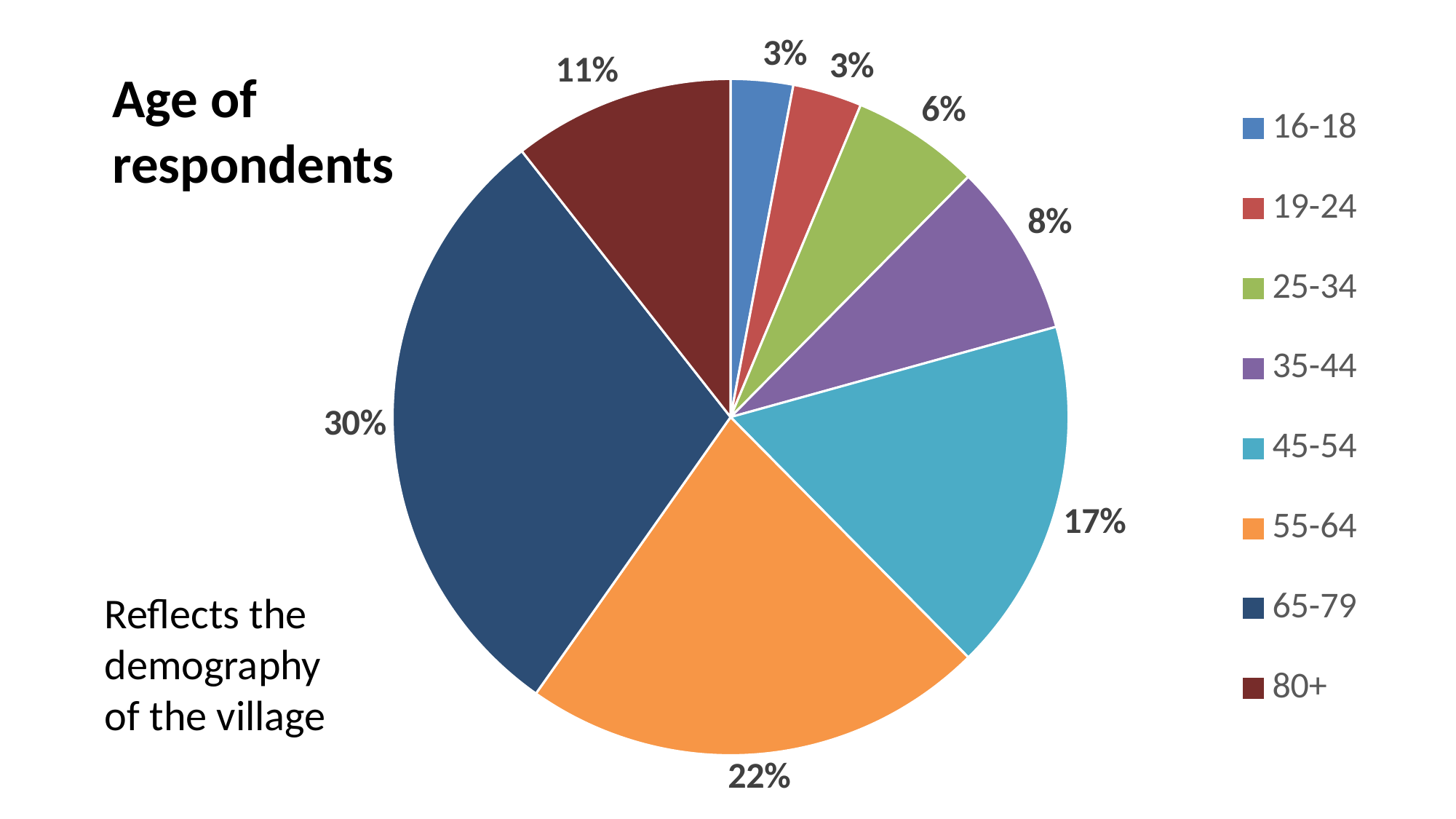
What share of respondents are aged 65-79? 30% What is the difference between the shares for 65-79 and 55-64? 8% What share of respondents are aged 45-54? 17% What share of respondents are aged 80+? 11% Which has a larger share, 45-54 or 80+? 45-54 What share of respondents are aged 35-44? 8% What share of respondents are aged 25-34? 6% What is the title of the chart? Age of respondents What kind of chart is shown on the slide? pie chart What share of respondents are aged 55-64? 22% Which age group has the largest share of respondents? 65-79 How many age groups does the legend list? 8